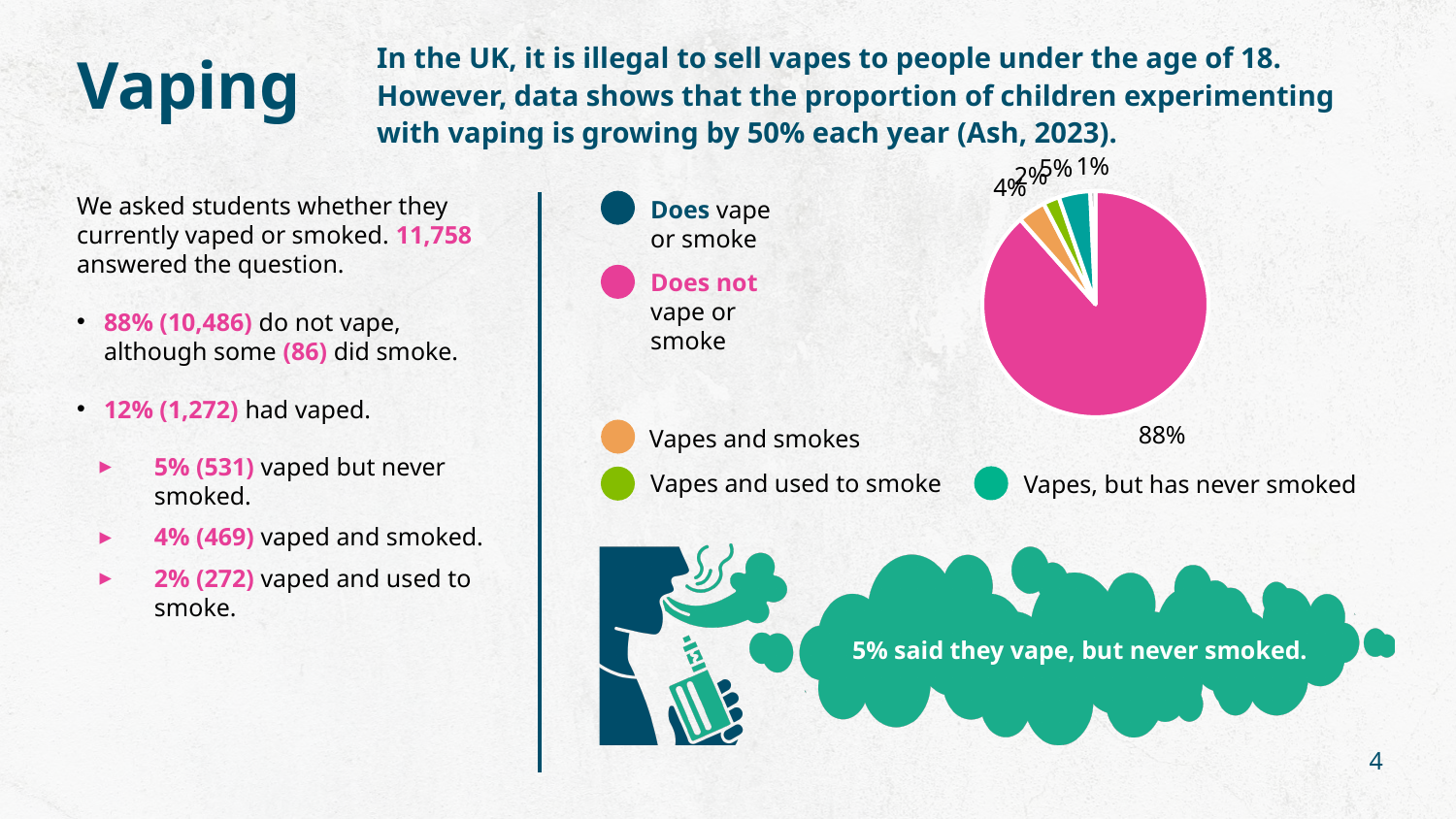
How many entries does the chart legend list? 5 What is the smallest percentage labelled on the pie chart? 1% What colour is the 'Does not vape or smoke' slice in the pie chart? pink What is the difference between the 'Does not vape or smoke' slice and the 'Vapes, but has never smoked' slice? 83% Which is larger in the pie chart: the 'Vapes and smokes' slice or the 'Vapes and used to smoke' slice? Vapes and smokes What share of the pie does the 'Vapes and used to smoke' slice represent? 2% How many slices does the pie chart have? 5 What kind of chart is shown on the slide? pie chart Which slice of the pie chart is the largest? Does not vape or smoke What share of the pie does the 'Vapes and smokes' slice represent? 4% What share of the pie does the 'Vapes, but has never smoked' slice represent? 5%